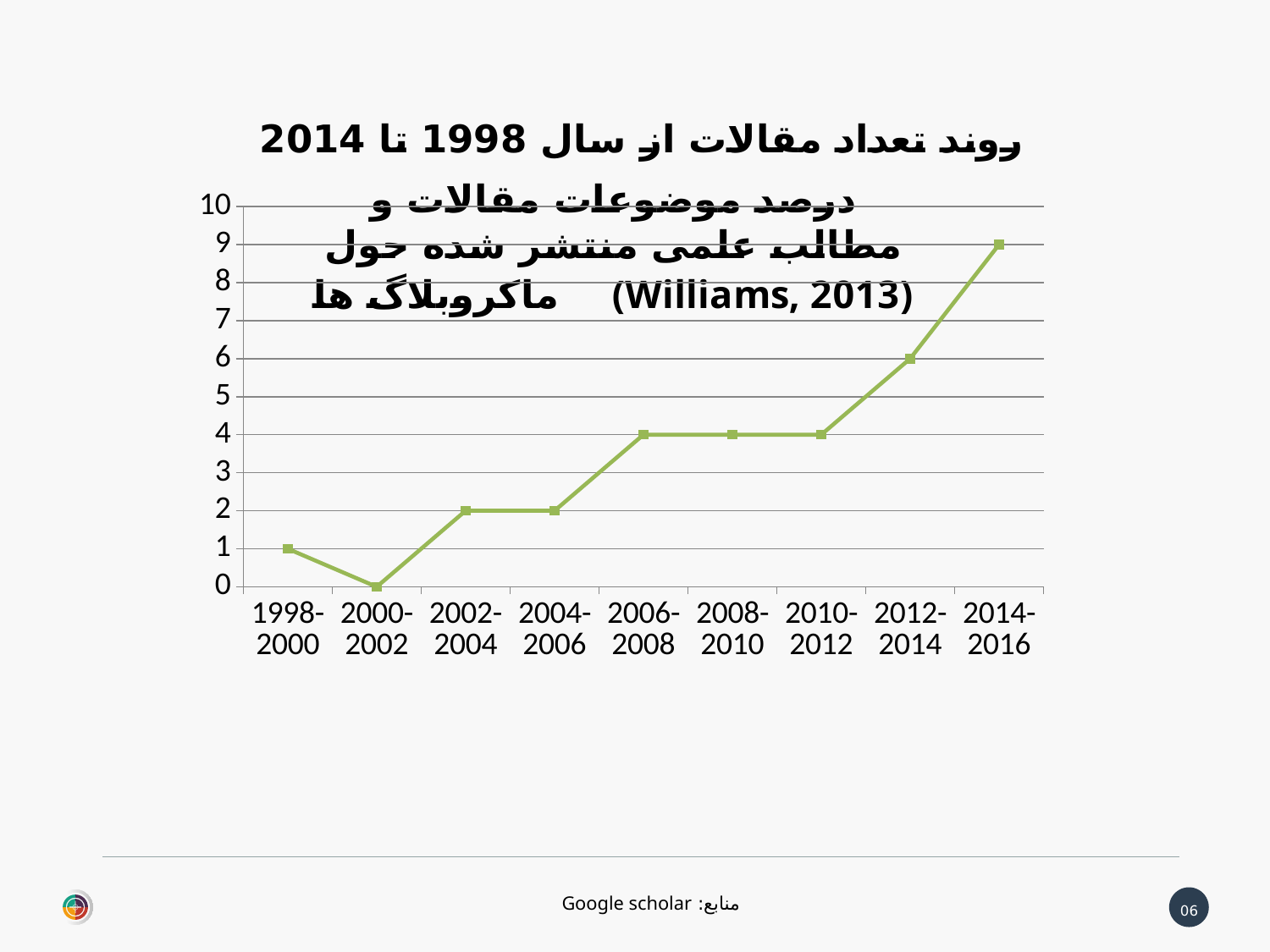
Which period has the highest value? 2014-2016 What is the value for the 2014-2016 period? 9 What is the value for the 1998-2000 period? 1 How many time periods are plotted along the x axis? 9 What is the value for the 2012-2014 period? 6 What type of chart is shown on the slide? line chart What is the value for the 2000-2002 period? 0 Which period has the lowest value? 2000-2002 Overall, do the values rise or fall from 1998-2000 to 2014-2016? rise What is the value for the 2006-2008 period? 4 What is the difference between the values for 2014-2016 and 2012-2014? 3 Which is larger, the value for 2002-2004 or the value for 2010-2012? 2010-2012